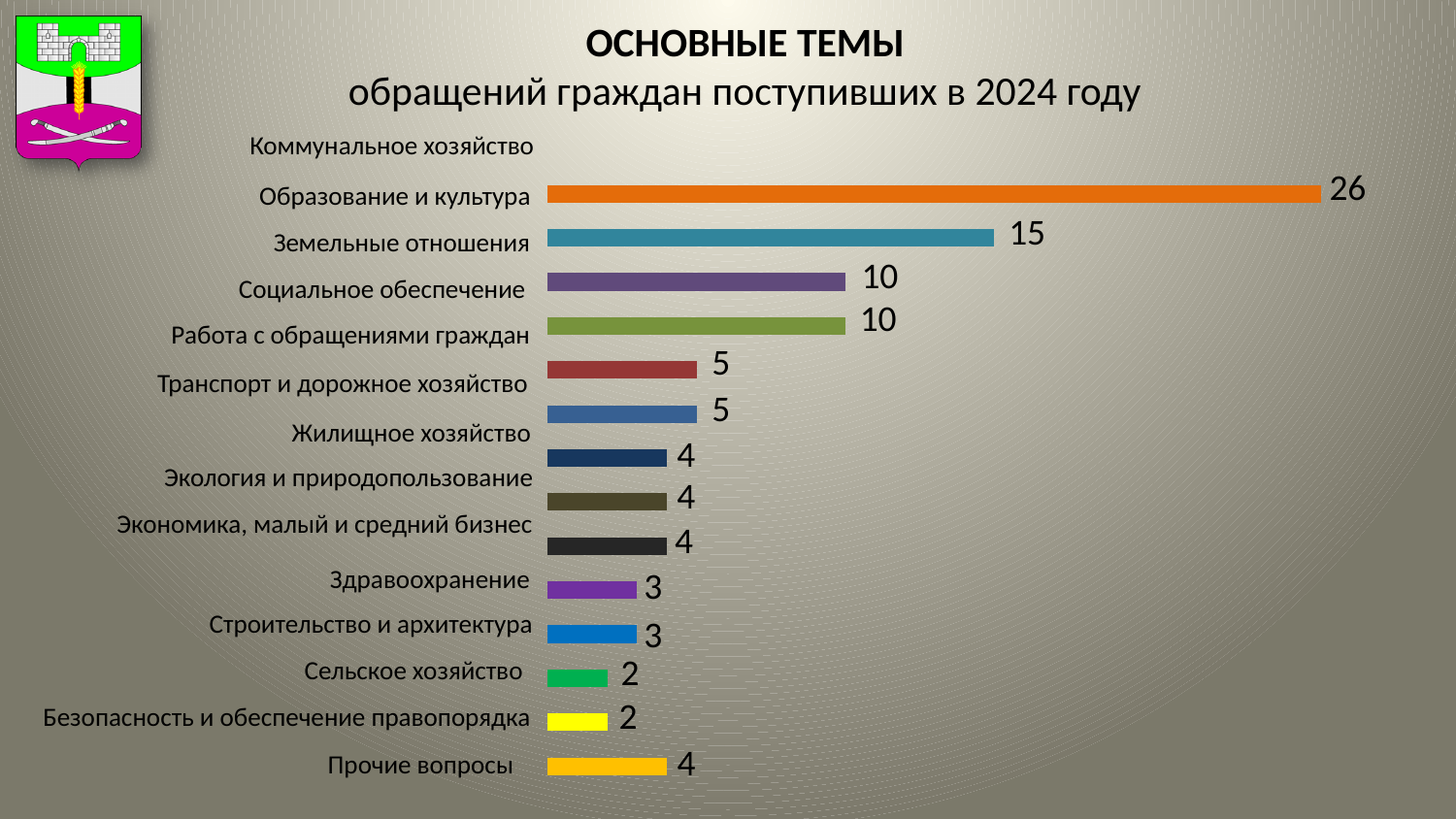
What is the difference between the value for Социальное обеспечение and the value for Транспорт и дорожное хозяйство? 5 What is the value for Прочие вопросы? 4 What is the value for Транспорт и дорожное хозяйство? 5 How many bars are plotted on the chart? 14 Which is larger, the value for Социальное обеспечение or the value for Здравоохранение? Социальное обеспечение What year do the citizens' appeals in the chart title refer to? 2024 What is the highest value shown on the chart? 26 What is the value for Безопасность и обеспечение правопорядка? 2 What kind of chart is shown on the slide? bar chart What is the value for Социальное обеспечение? 10 What is the value for Строительство и архитектура? 3 What is the lowest value shown on the chart? 2